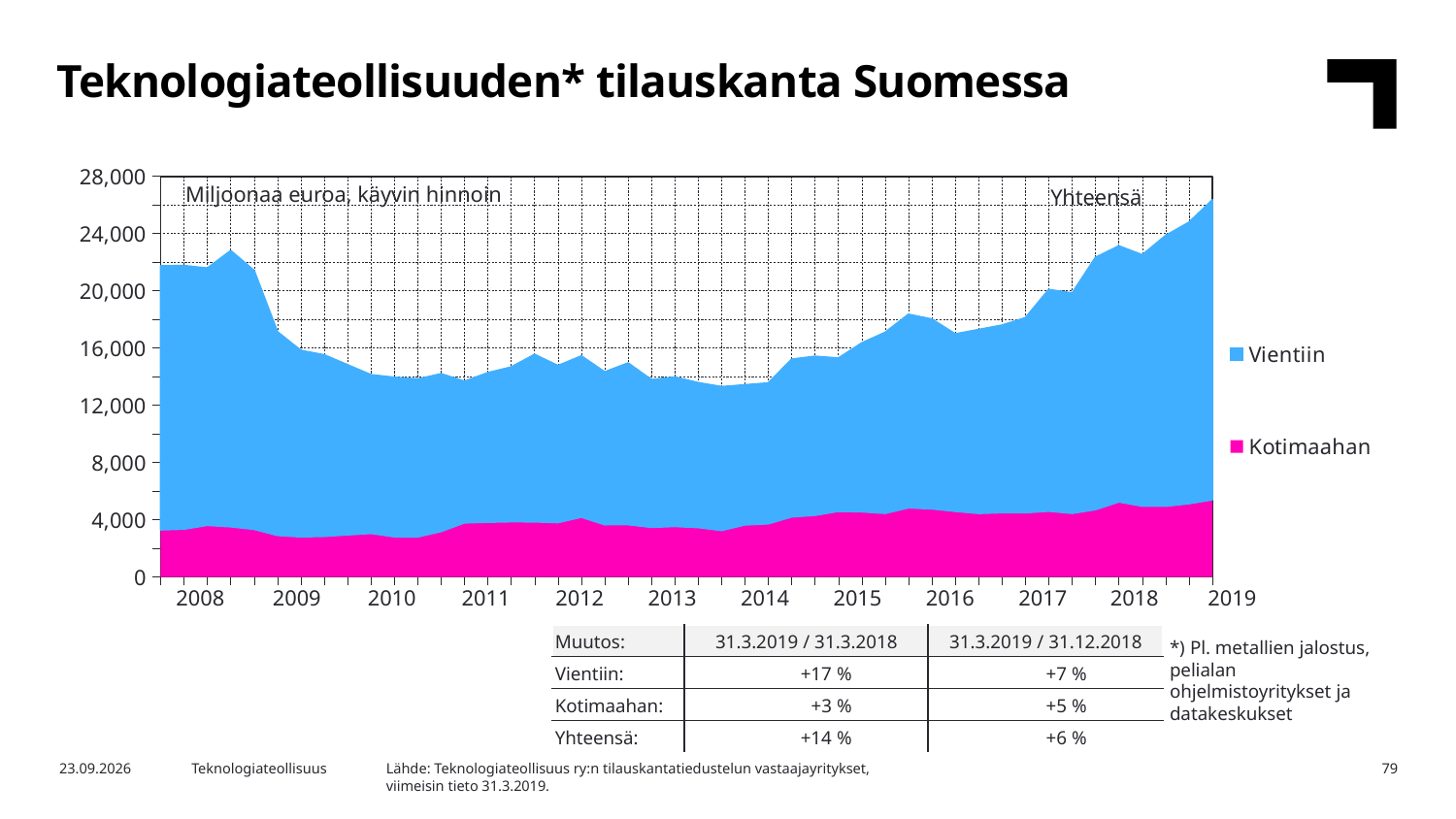
How many series does the chart legend list? 2 In which year shown on the x axis does the total (Yhteensä) reach its highest level? 2019 Is the total (Yhteensä) value at the start of 2008 greater or less than 20,000? greater Is the total (Yhteensä) value at 2013 greater or less than 16,000? less Is the Kotimaahan value at 2010 greater or less than 4,000? less What kind of chart is shown on the slide? Area chart Does the total (Yhteensä) rise or fall between 2017 and 2019? rise Which series is larger throughout the chart, Vientiin or Kotimaahan? Vientiin Which two series are listed in the chart legend? Vientiin and Kotimaahan What unit is stated in the chart's label at the top left of the plot area? Miljoonaa euroa, käyvin hinnoin